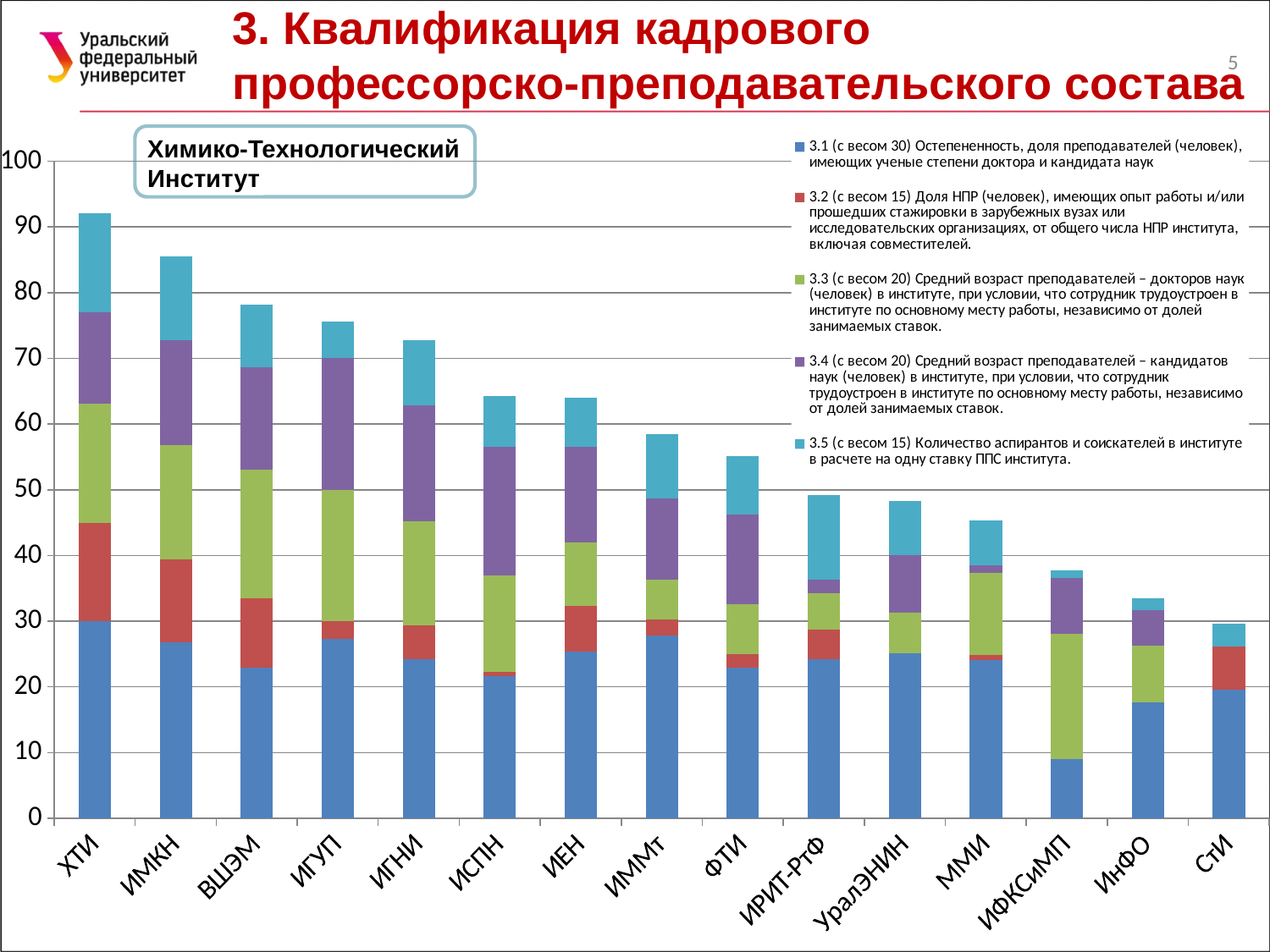
Is the total value for СтИ greater or less than 40? less Which institute has the lowest total bar in the chart? СтИ Is the total value for ХТИ greater or less than 80? greater Do the total bar heights rise or fall from left to right along the x axis? fall How many series does the legend of the chart list? 5 How many institutes (categories) are shown on the x axis of the chart? 15 Which institute has the highest total bar in the chart? ХТИ Is the total value for ИМКН greater or less than 80? greater Which institute has the larger total bar, ФТИ or ИРИТ-РтФ? ФТИ What kind of chart is shown on the slide? stacked bar chart Which institute is highlighted in the box at the top of the chart? Химико-Технологический Институт